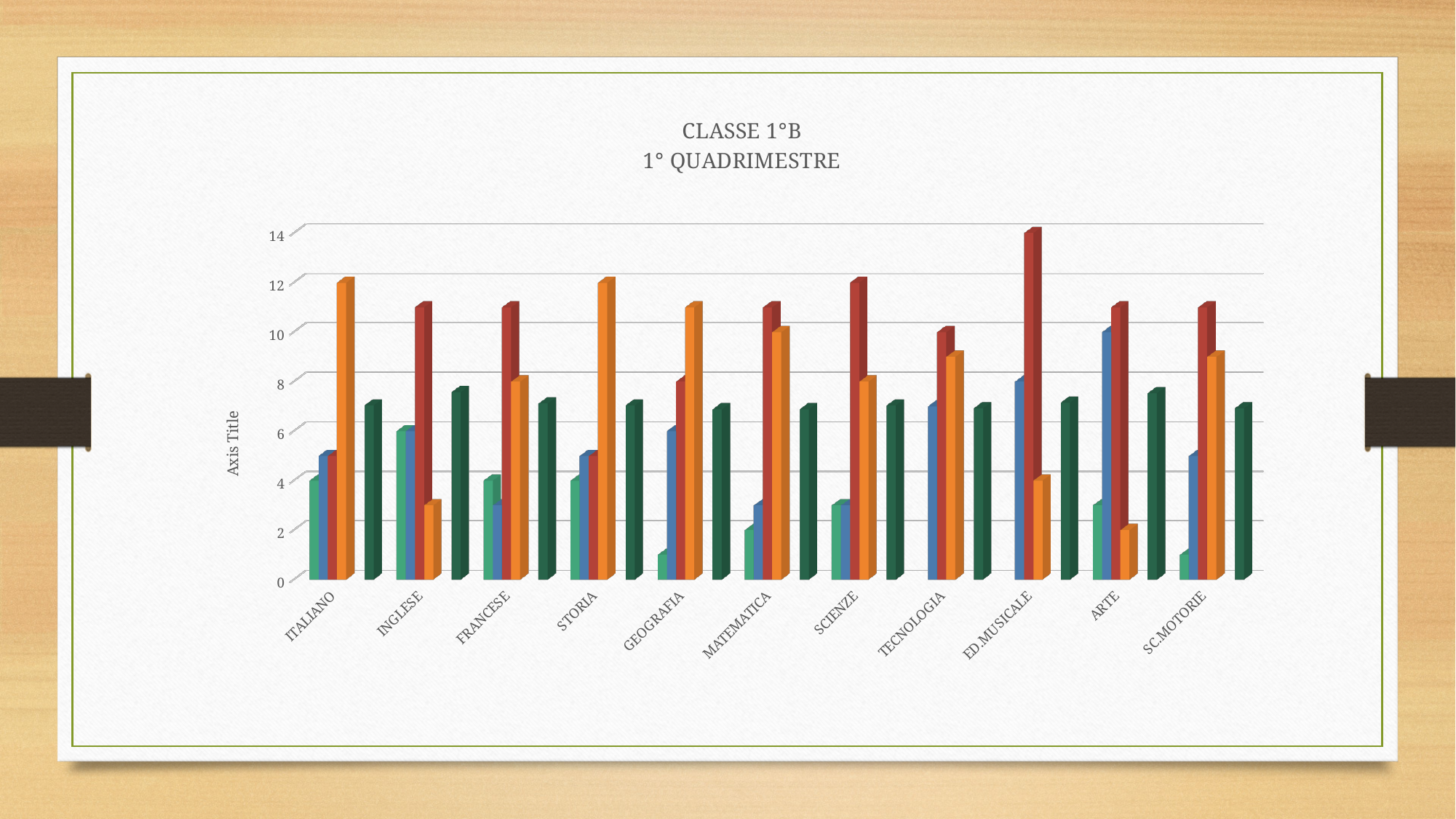
Is the orange bar for ITALIANO greater or less than 10? greater How many bars are drawn for the ITALIANO category? 5 Which category contains the tallest bar in the chart? ED.MUSICALE What kind of chart is shown on the slide? bar chart Is the orange bar for ARTE greater or less than 4? less For ITALIANO, which is taller: the orange bar or the red bar? the orange bar How many subject categories are shown on the x axis? 11 Is the light green bar for GEOGRAFIA greater or less than 2? less What label is shown on the vertical axis? Axis Title What is the title of the chart? CLASSE 1°B 1° QUADRIMESTRE For ARTE, which is taller: the blue bar or the orange bar? the blue bar